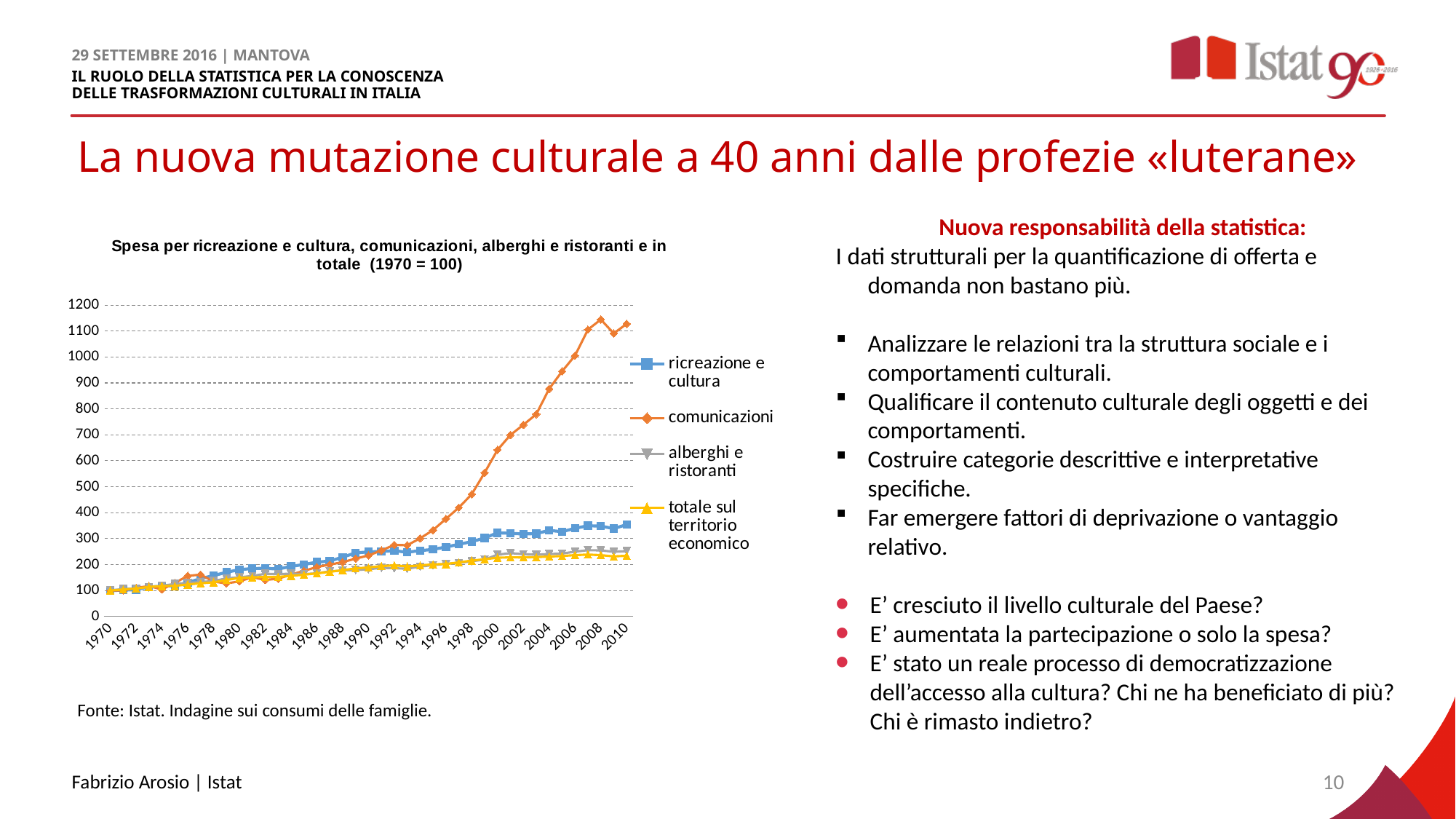
Which series has the lowest value in 2010? totale sul territorio economico Does the comunicazioni series rise or fall from 1990 to 2008? rise Is the value for comunicazioni in 2000 greater or less than 500? greater Which series has the highest value in 2010? comunicazioni What is the source cited below the chart? Istat. Indagine sui consumi delle famiglie. How many series does the chart legend list? 4 Is the value for comunicazioni in 2010 greater or less than 1000? greater Is the value for alberghi e ristoranti in 2010 greater or less than 300? less What is the index value of all series in the base year 1970? 100 What kind of chart is shown on the slide? line chart Which is larger in 2006, ricreazione e cultura or totale sul territorio economico? ricreazione e cultura